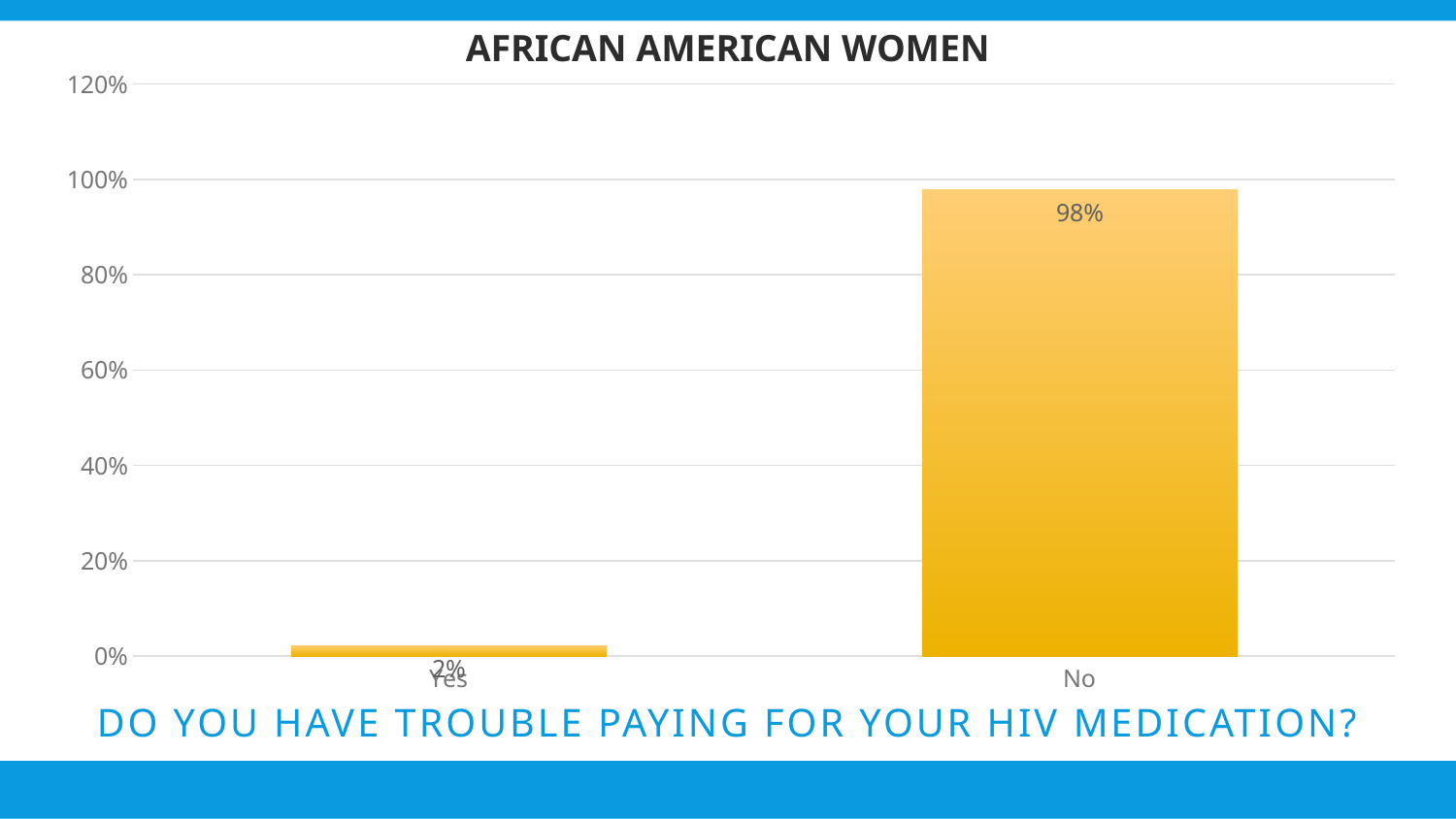
What is the difference between the "No" and "Yes" percentages? 96% What kind of chart is shown on the slide? Bar chart Is the value for "Yes" greater or less than 20%? less What is the highest value labelled on the vertical axis? 120% Which response category has the lowest value? Yes How many response categories are shown on the x axis? 2 What percentage of African American women answered "No" to having trouble paying for their HIV medication? 98% Which response category has the highest value? No Which is larger, the value for "Yes" or the value for "No"? No What is the title of the chart? AFRICAN AMERICAN WOMEN Is the value for "No" greater or less than 80%? greater What percentage of African American women answered "Yes" to having trouble paying for their HIV medication? 2%